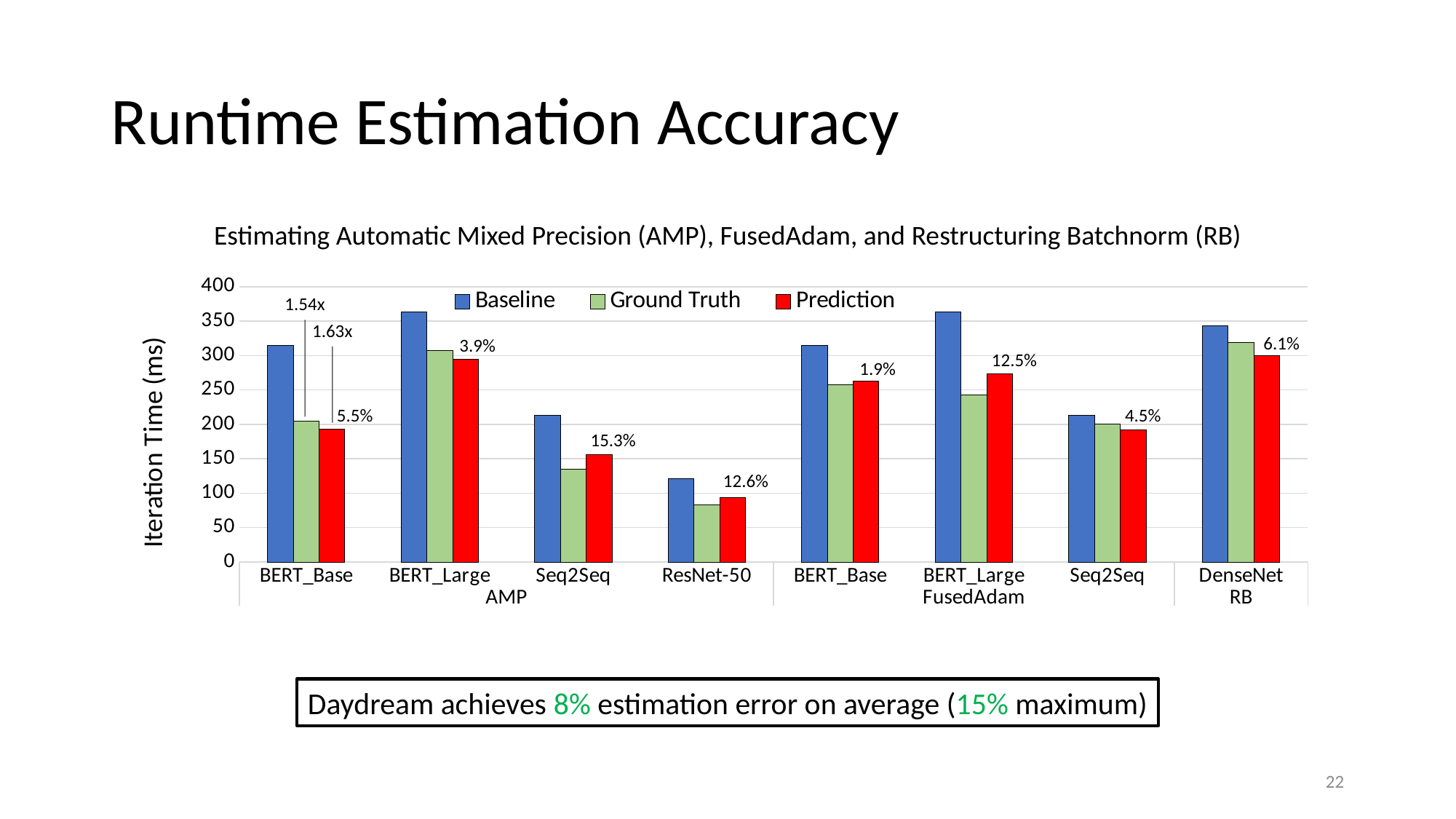
For Seq2Seq under AMP, which is larger: the Ground Truth value or the Prediction value? Prediction Is the Prediction value for Seq2Seq under AMP greater or less than 200? less What kind of chart is shown on the slide? bar chart What estimation error percentage is annotated above the Seq2Seq bars under AMP? 15.3% Is the Ground Truth value for ResNet-50 greater or less than 100? less Which is larger: the Baseline value for BERT_Base under AMP or the Baseline value for Seq2Seq under AMP? BERT_Base Is the Baseline value for BERT_Base under AMP greater or less than 300? greater What is the title of the chart? Estimating Automatic Mixed Precision (AMP), FusedAdam, and Restructuring Batchnorm (RB) What is the label of the y axis? Iteration Time (ms) How many series does the legend list? 3 How many model groups (categories) are plotted along the x axis? 8 Which category has the lowest Baseline value? ResNet-50